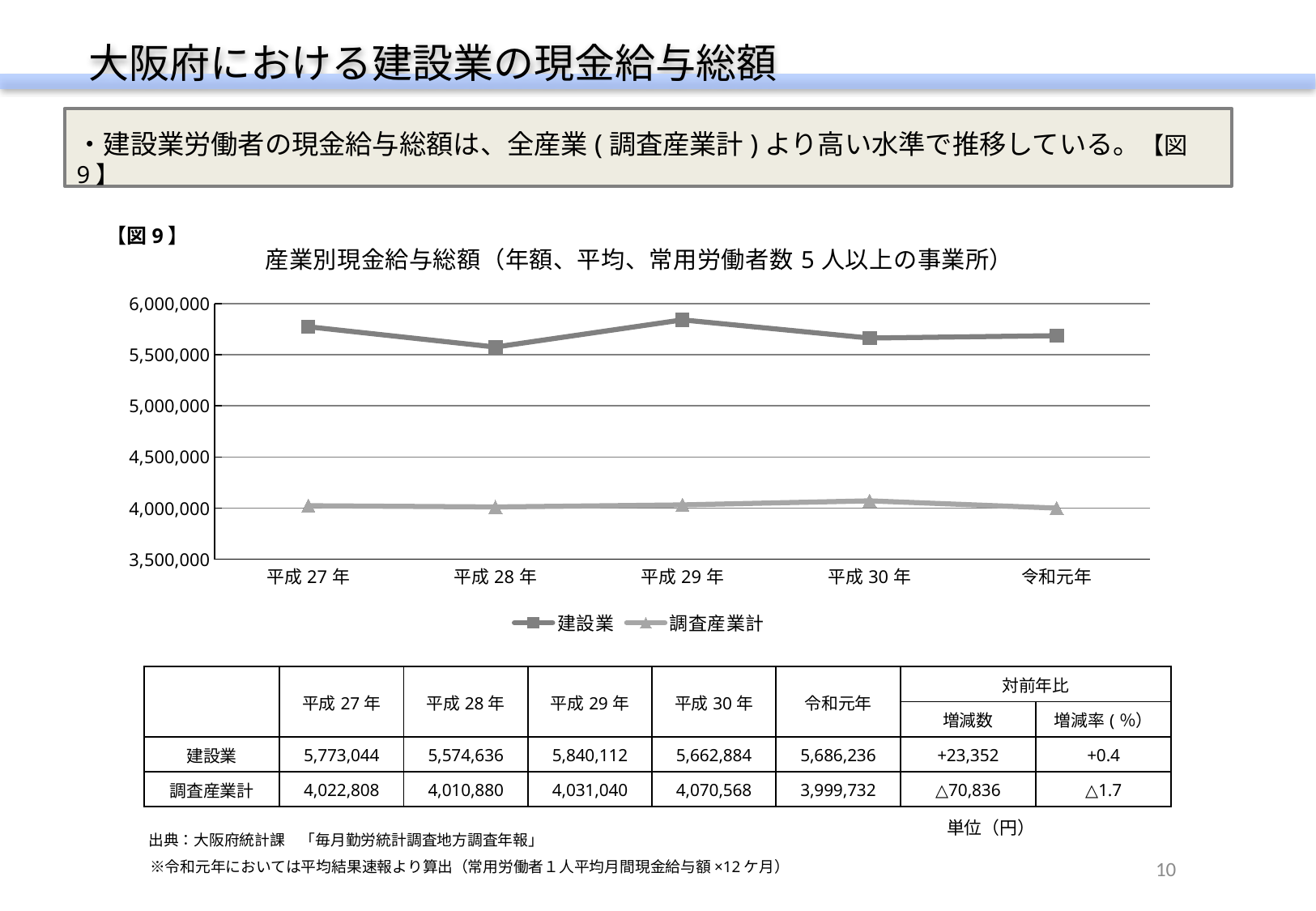
How many series does the legend of the chart list? 2 What is the value for 建設業 in 平成29年? 5,840,112 In which year is the value for 建設業 highest? 平成29年 What kind of chart is shown in 【図9】? line chart What is the difference between 建設業 and 調査産業計 in 平成27年? 1,750,236 In which year is the value for 調査産業計 highest? 平成30年 Which series has the larger value in 平成30年, 建設業 or 調査産業計? 建設業 What is the value for 調査産業計 in 令和元年? 3,999,732 Does the value for 建設業 rise or fall from 平成29年 to 平成30年? fall In which year is the value for 建設業 lowest? 平成28年 How many years (points) are plotted along the x axis of the chart? 5 Is the value for 建設業 in 平成28年 greater or less than 5,500,000? greater